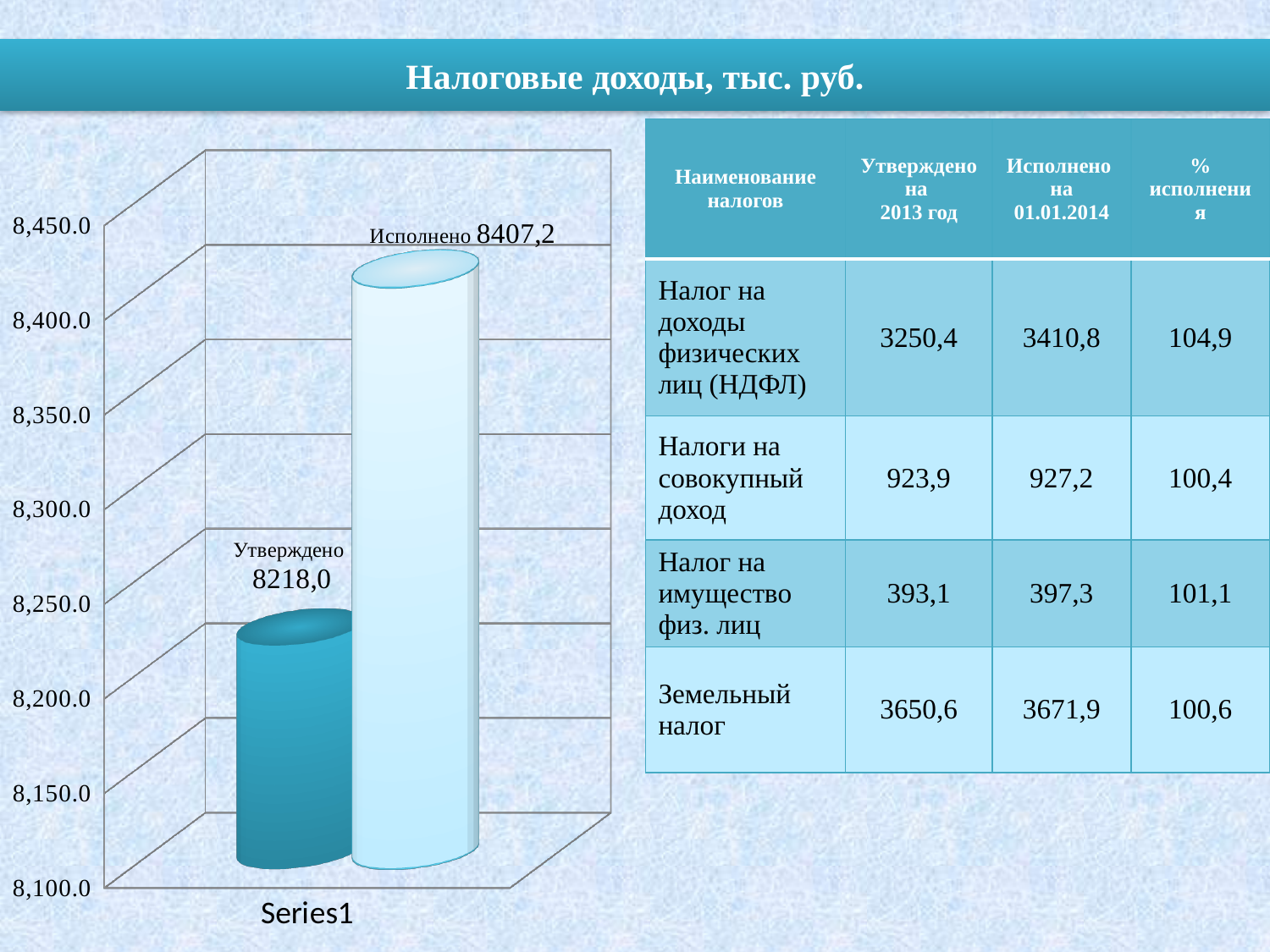
Is the value for Утверждено greater or less than 8,300.0? less Which bar in the chart is the highest? Исполнено How many bars are plotted in the chart? 2 What is the title of the slide containing the chart? Налоговые доходы, тыс. руб. What kind of chart is shown on the slide? bar chart Is the value for Исполнено greater or less than 8,400.0? greater What is the value of the Исполнено bar in the chart? 8407,2 What is the value of the Утверждено bar in the chart? 8218,0 What is the difference between the Исполнено and Утверждено values in the chart? 189,2 What label appears on the horizontal axis of the chart? Series1 Which is larger in the chart, Утверждено or Исполнено? Исполнено Which bar in the chart is the lowest? Утверждено